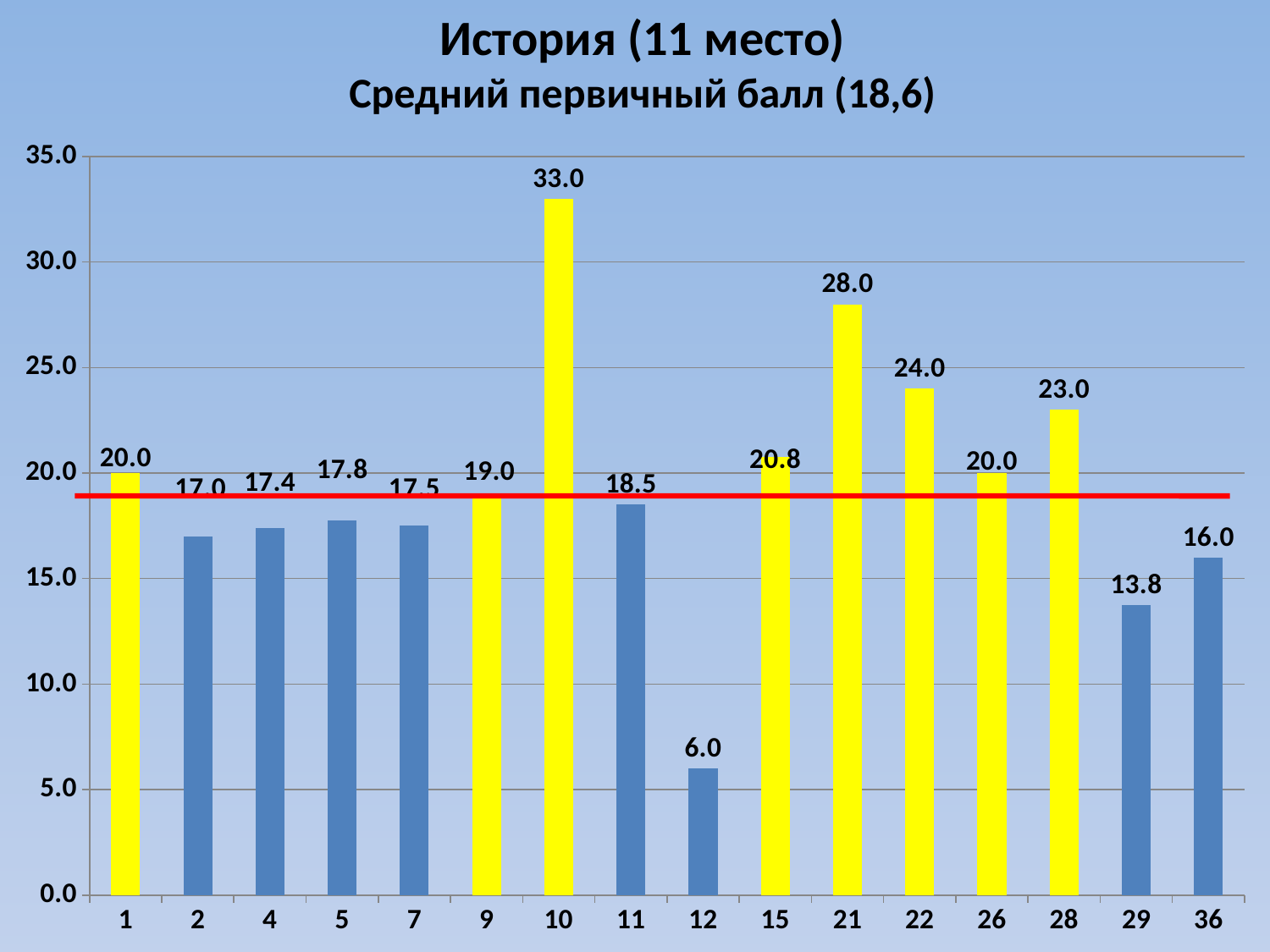
Is the value for category 11 greater or less than 20.0? less How many categories are shown on the x axis? 16 What is the value for category 10? 33.0 What is the difference between the values for category 21 and category 22? 4.0 What is the value for category 29? 13.8 What is the value for category 15? 20.8 What is the title of the chart? История (11 место) Средний первичный балл (18,6) Which is larger, the value for category 28 or the value for category 36? 28 Which category has the lowest value? 12 Which category has the highest value? 10 What kind of chart is shown on the slide? bar chart What is the difference between the values for category 10 and category 12? 27.0